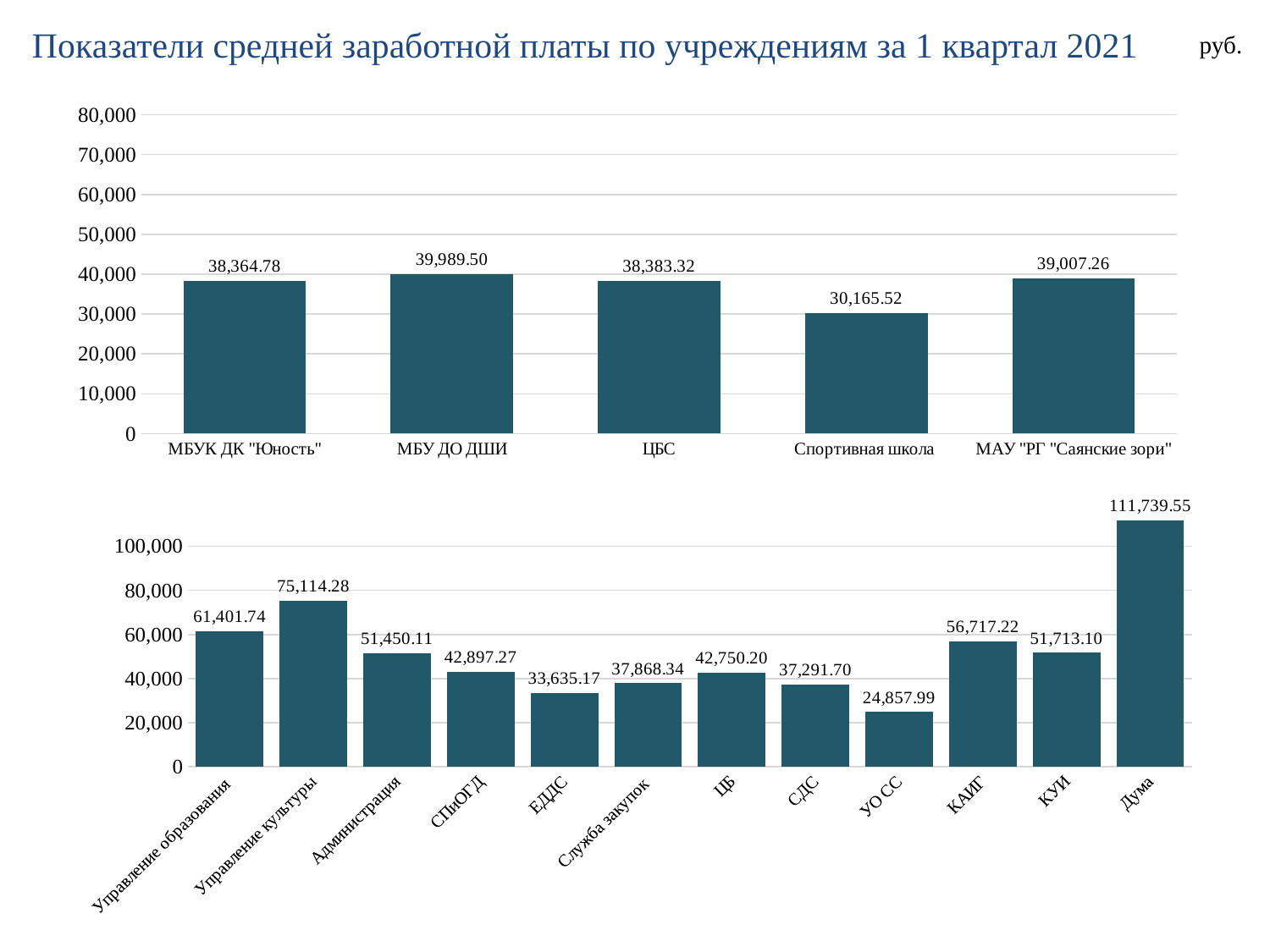
In the bottom chart, which is larger: the value for СПиОГД or the value for ЦБ? СПиОГД In the top chart, what is the difference between the values for МБУ ДО ДШИ and Спортивная школа? 9,823.98 In the bottom chart, what is the value for КАИГ? 56,717.22 In the top chart, which category has the highest value? МБУ ДО ДШИ In the top chart, which category has the lowest value? Спортивная школа How many categories are shown in the top chart? 5 What type of chart is the bottom chart? Bar chart In the bottom chart, which category has the highest value? Дума How many categories are shown in the bottom chart? 12 In the top chart, what is the value for ЦБС? 38,383.32 In the bottom chart, which category has the lowest value? УО СС In the bottom chart, what is the difference between the values for Управление культуры and Управление образования? 13,712.54